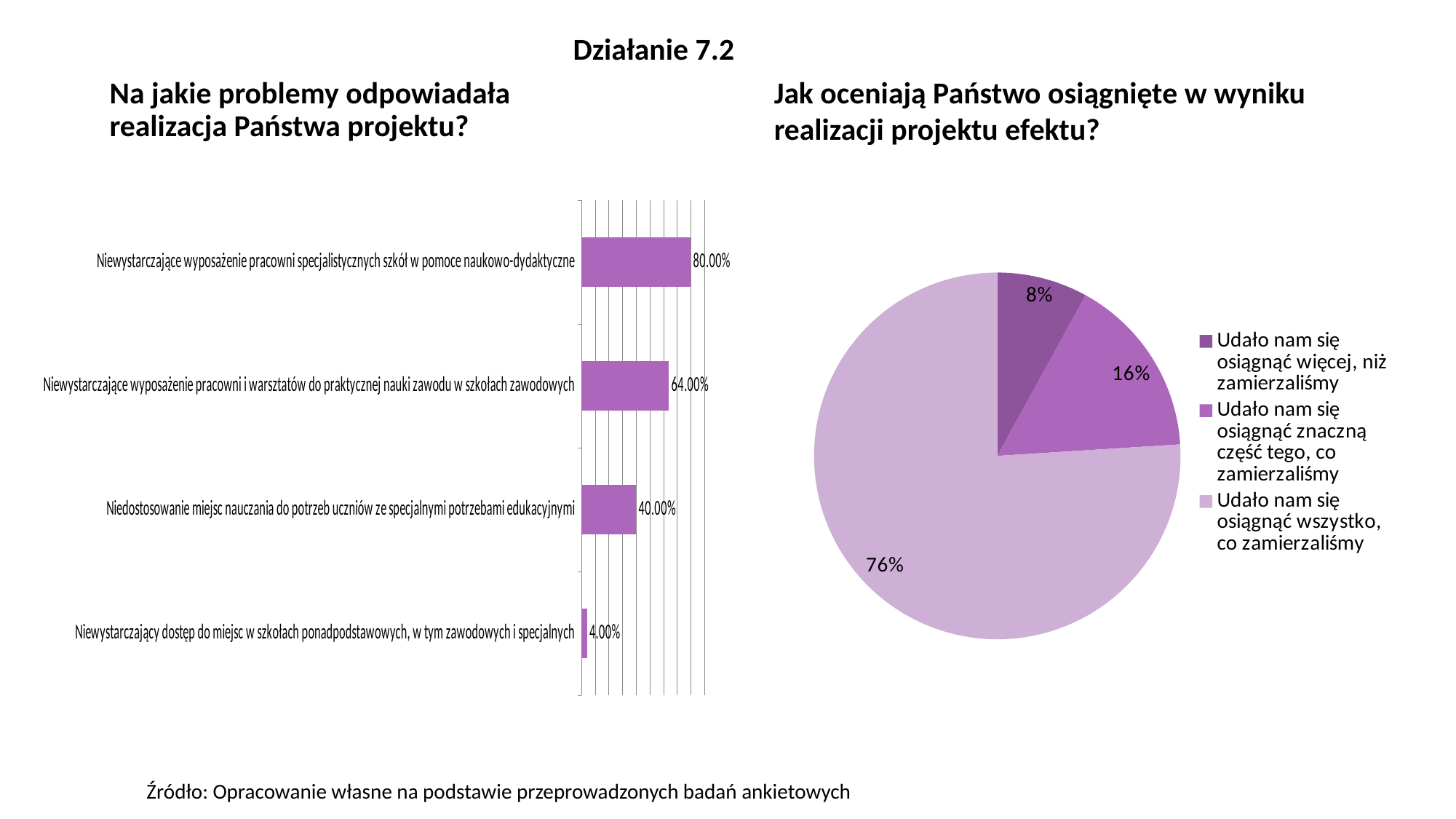
What kind of chart is the chart on the left side of the slide? Bar chart In the right pie chart, how many entries does the legend list? 3 In the right pie chart, which slice is the largest? Udało nam się osiągnąć wszystko, co zamierzaliśmy In the left bar chart, what is the value for 'Niewystarczające wyposażenie pracowni specjalistycznych szkół w pomoce naukowo-dydaktyczne'? 80.00% In the right pie chart, which is larger: the slice for 'Udało nam się osiągnąć znaczną część tego, co zamierzaliśmy' or the slice for 'Udało nam się osiągnąć więcej, niż zamierzaliśmy'? Udało nam się osiągnąć znaczną część tego, co zamierzaliśmy In the left bar chart, how many categories are shown? 4 In the right pie chart, what share is labelled for 'Udało nam się osiągnąć więcej, niż zamierzaliśmy'? 8% In the left bar chart, which category has the highest value? Niewystarczające wyposażenie pracowni specjalistycznych szkół w pomoce naukowo-dydaktyczne In the right pie chart, what share is labelled for 'Udało nam się osiągnąć wszystko, co zamierzaliśmy'? 76% In the left bar chart, what is the value for 'Niedostosowanie miejsc nauczania do potrzeb uczniów ze specjalnymi potrzebami edukacyjnymi'? 40.00% In the left bar chart, what is the difference between the values for 'Niewystarczające wyposażenie pracowni specjalistycznych szkół w pomoce naukowo-dydaktyczne' and 'Niewystarczające wyposażenie pracowni i warsztatów do praktycznej nauki zawodu w szkołach zawodowych'? 16.00% In the left bar chart, which category has the lowest value? Niewystarczający dostęp do miejsc w szkołach ponadpodstawowych, w tym zawodowych i specjalnych